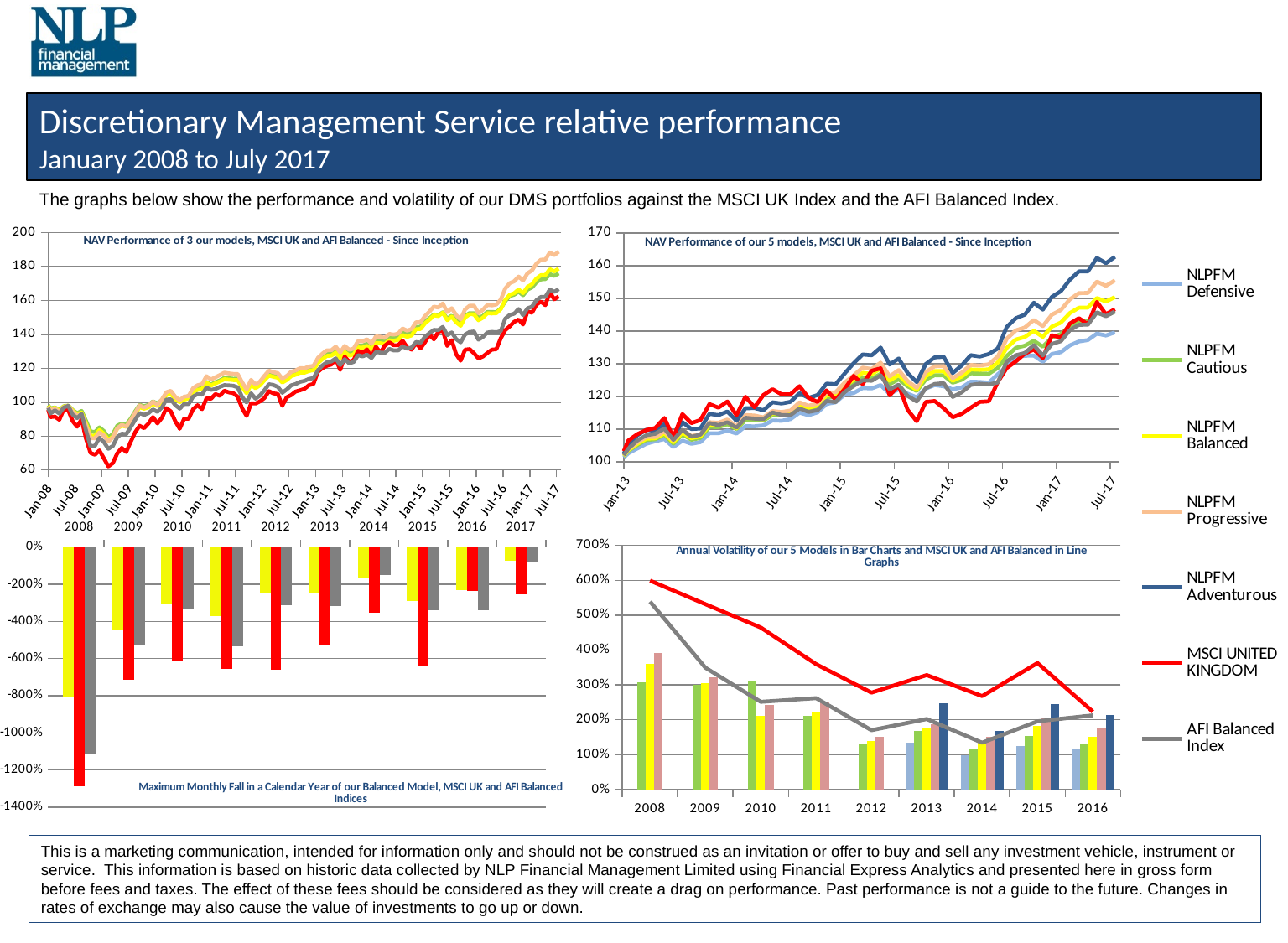
In the bottom-right chart 'Annual Volatility of our 5 Models in Bar Charts and MSCI UK and AFI Balanced in Line Graphs', does the MSCI United Kingdom line generally rise or fall from 2008 to 2016? Fall In the top-left chart 'NAV Performance of 3 our models, MSCI UK and AFI Balanced - Since Inception', which series is highest at Jul-17? NLPFM Progressive In the top-left chart 'NAV Performance of 3 our models, MSCI UK and AFI Balanced - Since Inception', is the NLPFM Progressive value at Jul-17 greater or less than 180? greater What period does the slide subtitle say the charts cover? January 2008 to July 2017 In the bottom-left chart 'Maximum Monthly Fall in a Calendar Year of our Balanced Model, MSCI UK and AFI Balanced Indices', which year has the largest fall for the red MSCI UK bar? 2008 How many years are shown on the x axis of the bottom-right chart 'Annual Volatility of our 5 Models in Bar Charts and MSCI UK and AFI Balanced in Line Graphs'? 9 How many entries does the shared legend on the right of the slide list? 7 In the top-right chart 'NAV Performance of our 5 models, MSCI UK and AFI Balanced - Since Inception', which series is highest at Jul-17? NLPFM Adventurous In the bottom-right chart 'Annual Volatility of our 5 Models in Bar Charts and MSCI UK and AFI Balanced in Line Graphs', is the MSCI United Kingdom value for 2012 greater or less than 300%? less What kind of chart is the bottom-left chart titled 'Maximum Monthly Fall in a Calendar Year of our Balanced Model, MSCI UK and AFI Balanced Indices'? Bar chart What kind of chart is the top-left chart titled 'NAV Performance of 3 our models, MSCI UK and AFI Balanced - Since Inception'? Line chart In the top-left chart 'NAV Performance of 3 our models, MSCI UK and AFI Balanced - Since Inception', is the lowest point of the MSCI United Kingdom line greater or less than 80? less